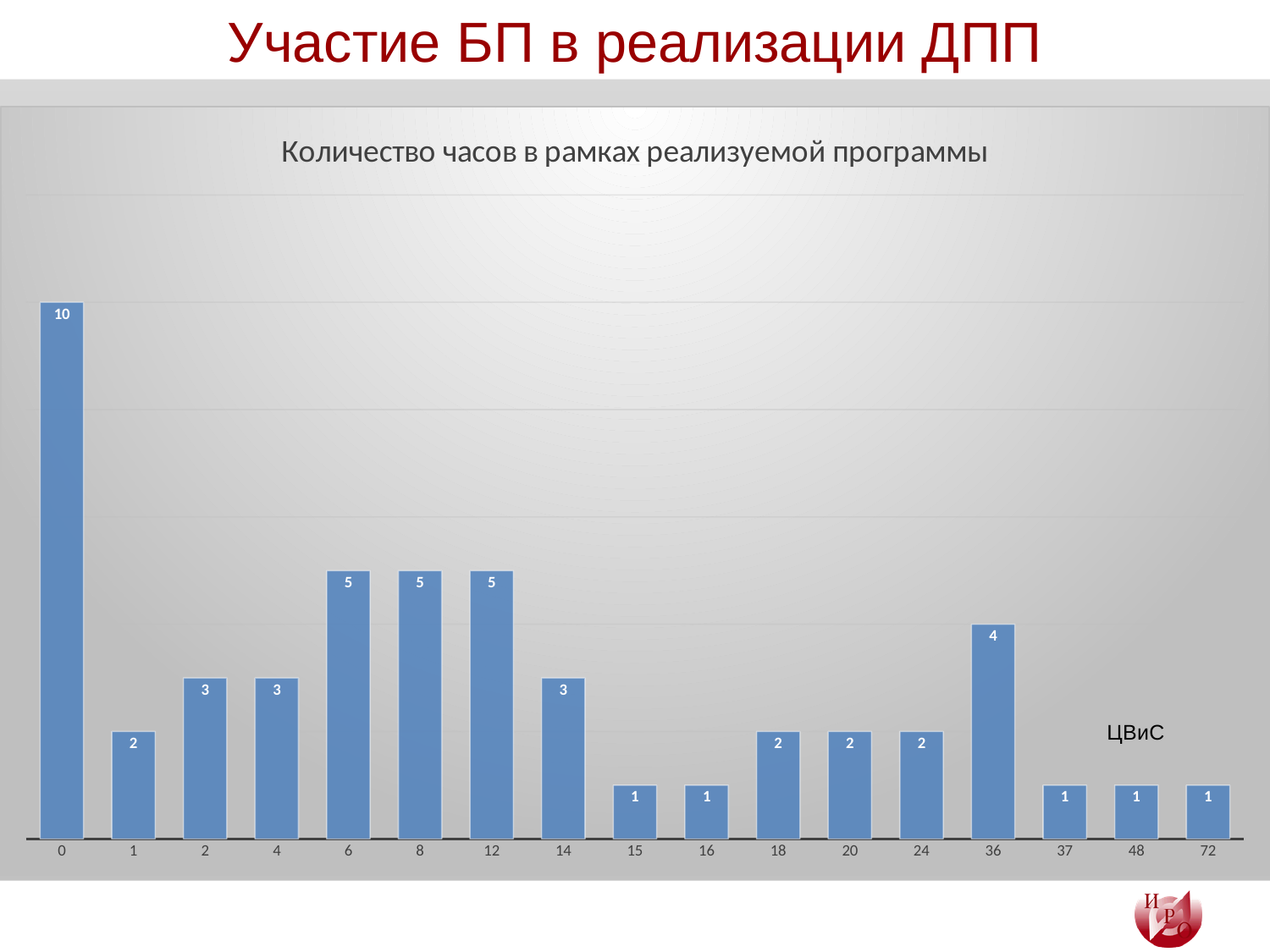
Which is larger, the value for category 36 or the value for category 24? category 36 What is the difference between the values for category 6 and category 18? 3 How many categories are shown on the x axis? 17 What kind of chart is shown on the slide? bar chart What is the value for category 0? 10 What is the value for category 14? 3 Which category has the highest value? 0 Which is larger, the value for category 2 or the value for category 15? category 2 What is the value for category 72? 1 What is the title of the chart? Количество часов в рамках реализуемой программы What is the value for category 36? 4 What is the difference between the values for category 0 and category 36? 6